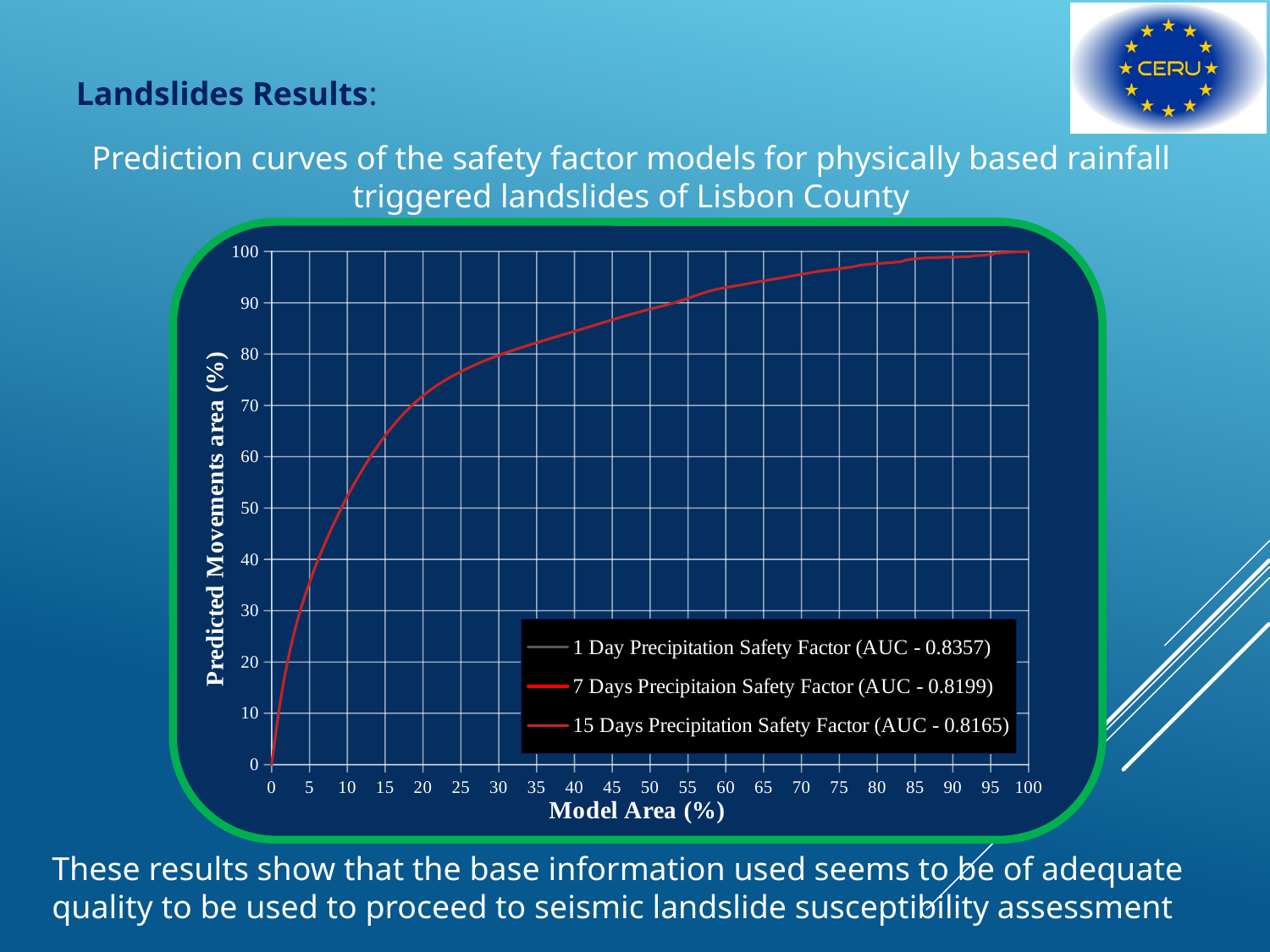
Do the prediction curves rise or fall as Model Area (%) increases? Rise What kind of chart is shown on the slide? Line chart Is the Predicted Movements area at a Model Area of 50% greater or less than 80? greater How many series does the legend list? 3 What is the title of the x axis? Model Area (%) Is the Predicted Movements area at a Model Area of 60% greater or less than 90? greater Is the Predicted Movements area at a Model Area of 5% greater or less than 30? greater What AUC value is listed in the legend for the 1 Day Precipitation Safety Factor? 0.8357 What is the Predicted Movements area (%) when the Model Area is 0%? 0 What is the Predicted Movements area (%) when the Model Area is 100%? 100